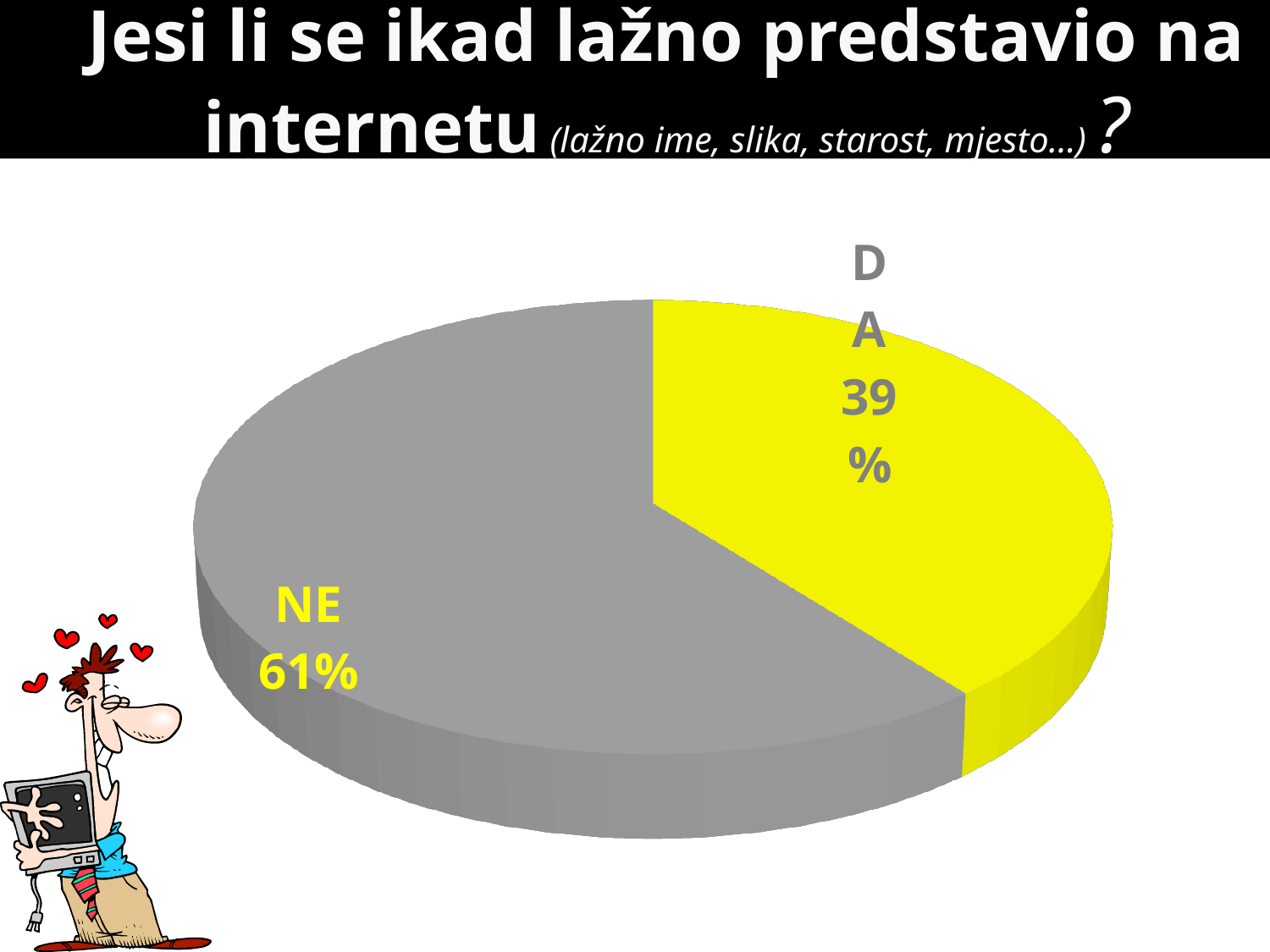
What kind of chart is shown on the slide? pie chart How many slices does the pie chart have? 2 What percentage of respondents answered NE? 61% What colour is the DA slice? yellow Which answer has the largest share of the pie? NE Which answer has the smallest share of the pie? DA Which is larger, the share for DA or the share for NE? NE What is the difference in percentage points between NE and DA? 22 What share of the pie does the DA slice represent? 39% What percentage of respondents answered DA? 39% What colour is the NE slice? grey